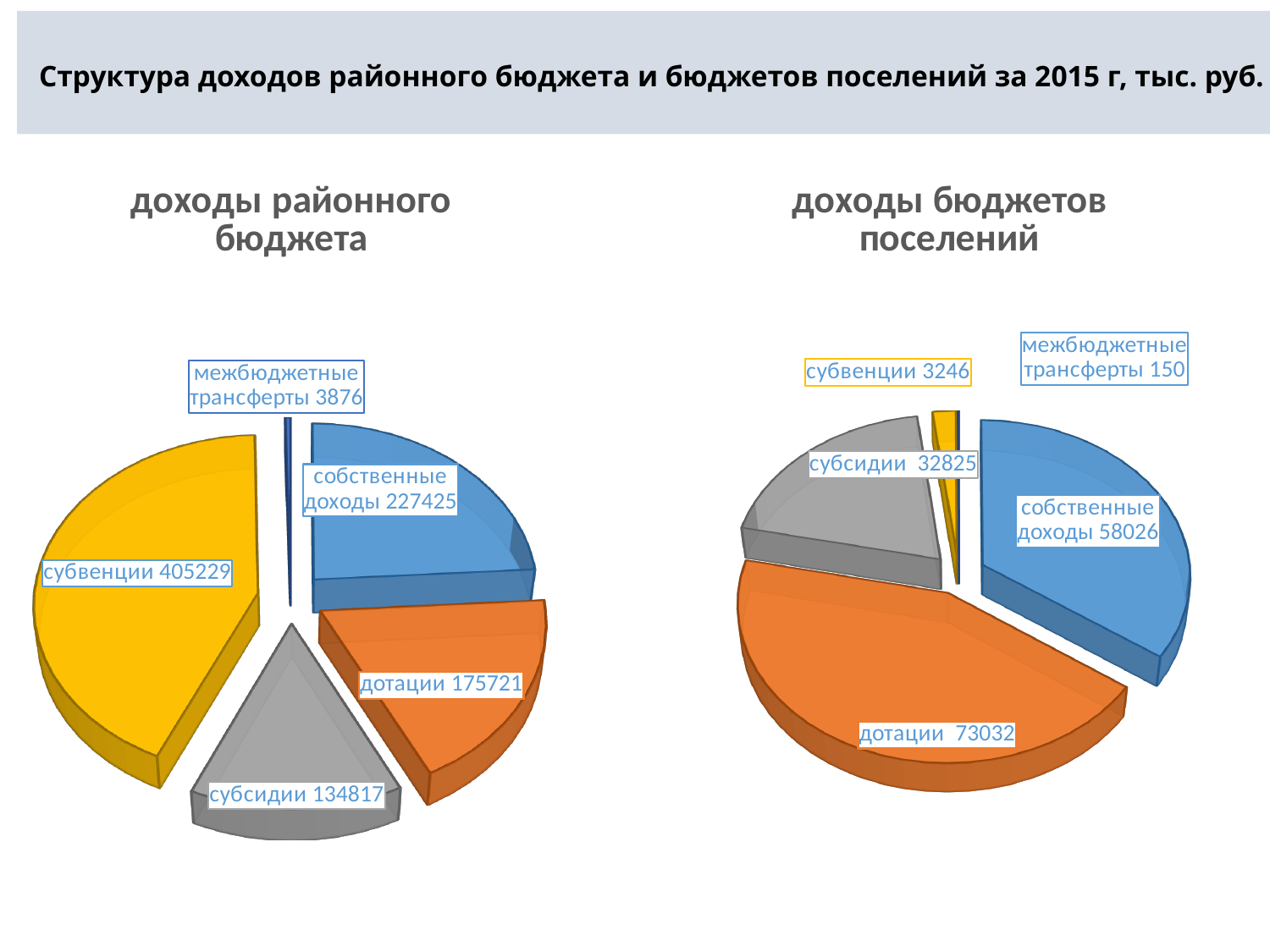
What type of chart is used on the right (доходы бюджетов поселений)? pie chart In the right chart (доходы бюджетов поселений), which category has the largest value? дотации In the left chart (доходы районного бюджета), what is the value for межбюджетные трансферты? 3876 How many slices does the left chart (доходы районного бюджета) have? 5 In the right chart (доходы бюджетов поселений), which category has the smallest value? межбюджетные трансферты In the left chart (доходы районного бюджета), what is the difference between собственные доходы and дотации? 51704 In the right chart (доходы бюджетов поселений), what is the value for дотации? 73032 In the right chart (доходы бюджетов поселений), which is larger: дотации or собственные доходы? дотации In the left chart (доходы районного бюджета), which category has the largest value? субвенции In the left chart (доходы районного бюджета), what is the value for субвенции? 405229 In the right chart (доходы бюджетов поселений), what is the value for субсидии? 32825 What is the title of the left chart? доходы районного бюджета